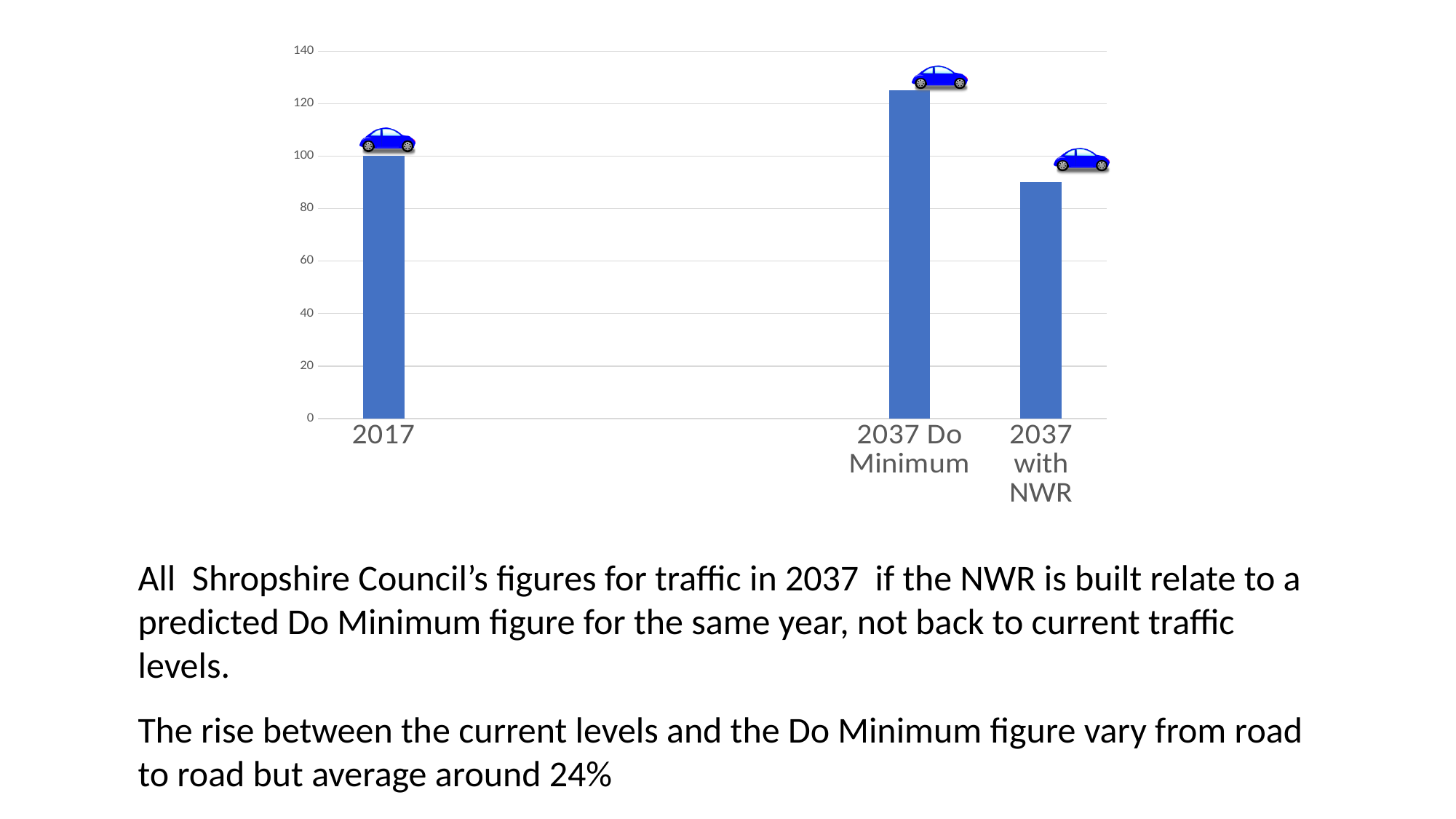
Does the value rise or fall from 2037 Do Minimum to 2037 with NWR? fall Which category has the highest value? 2037 Do Minimum Is the value for 2037 with NWR greater or less than 80? greater Which is larger, the value for 2017 or the value for 2037 with NWR? 2017 Which category has the lowest value? 2037 with NWR What is the value for 2017? 100 What is the highest tick value shown on the vertical axis? 140 How many categories are plotted on the chart? 3 Is the value for 2037 Do Minimum greater or less than 120? greater What kind of chart is shown on the slide? bar chart Is the value for 2037 with NWR greater or less than 100? less Which is larger, the value for 2037 Do Minimum or the value for 2017? 2037 Do Minimum